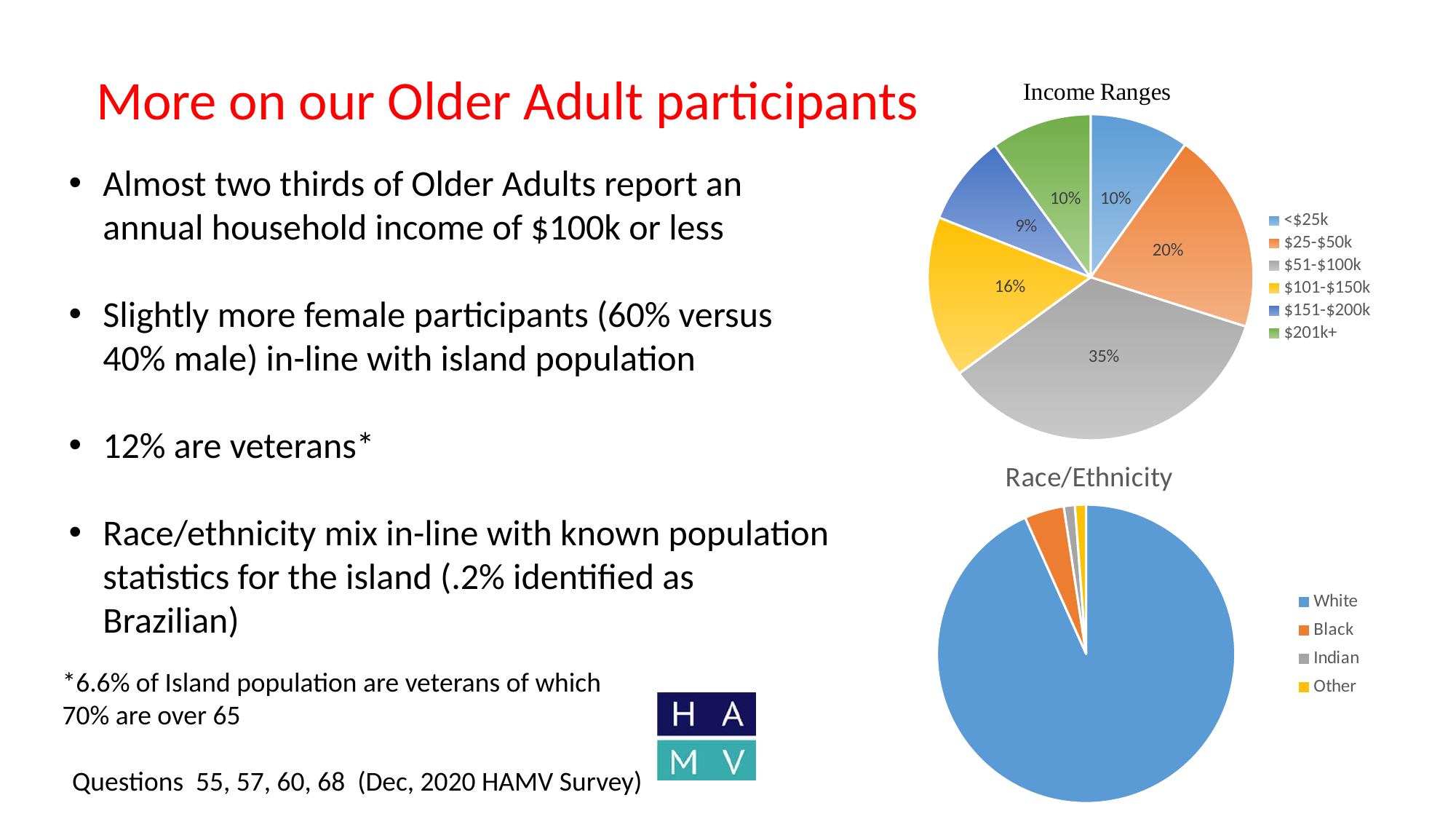
How many categories does the legend of the Race/Ethnicity chart list? 4 In the Income Ranges chart, what percentage is shown for the $25-$50k slice? 20% In the Income Ranges chart, what share of participants report an income of $51-$100k? 35% In the Income Ranges chart, which income range has the smallest share? $151-$200k In the Income Ranges chart, which slice is larger: $101-$150k or $151-$200k? $101-$150k In the Income Ranges chart, what percentage is shown for the $101-$150k slice? 16% How many income ranges are shown in the Income Ranges chart? 6 In the Race/Ethnicity chart, which category has the largest share? White In the Income Ranges chart, what is the difference in percentage points between the $51-$100k slice and the $25-$50k slice? 15 In the Income Ranges chart, which income range has the largest share? $51-$100k In the Income Ranges chart, what percentage is shown for the $151-$200k slice? 9% What type of chart is the Race/Ethnicity chart? Pie chart